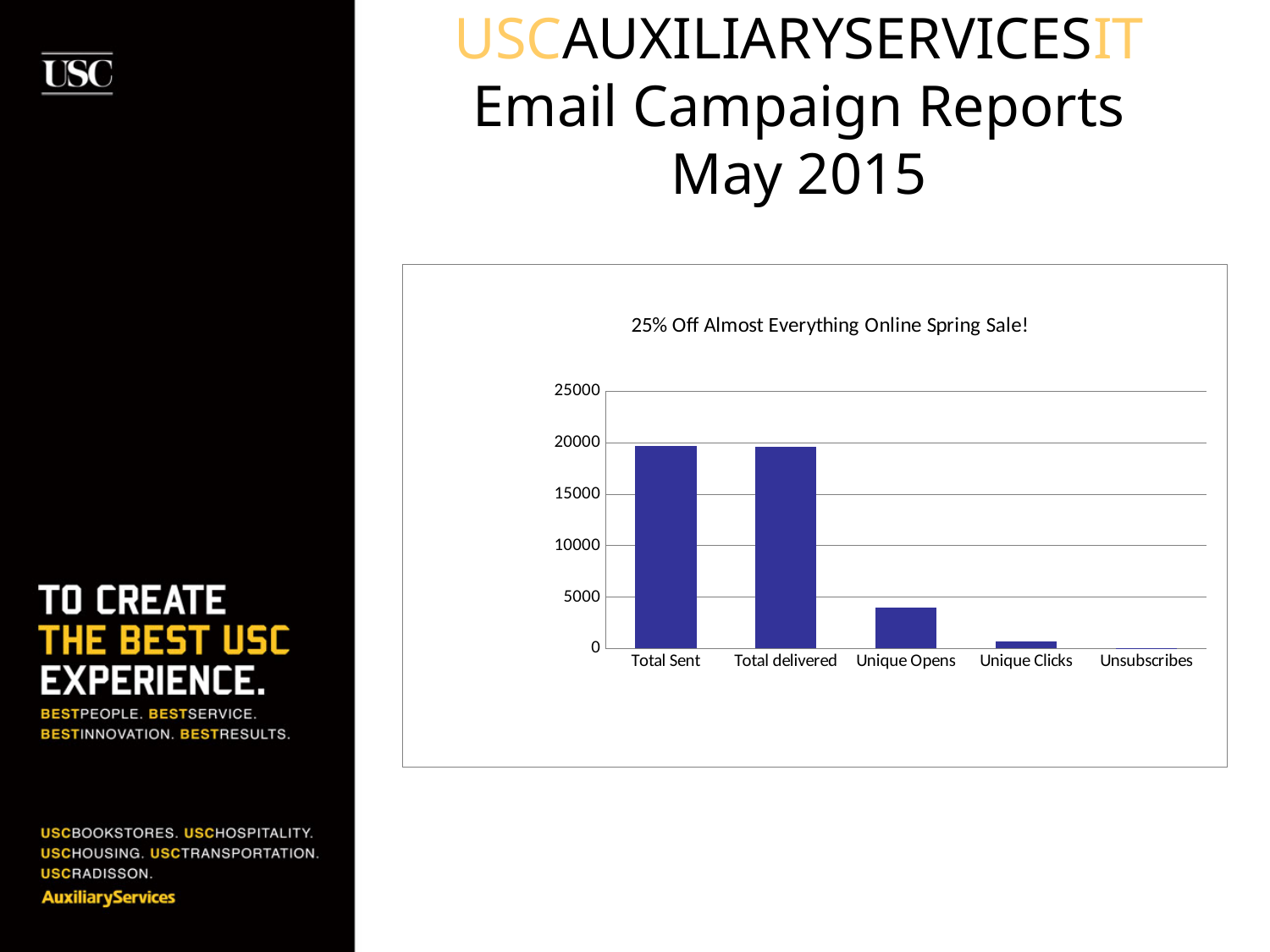
Do the values rise or fall moving from left to right along the x axis? fall Is the value for Total delivered greater or less than 10000? greater Which is larger, the value for Total delivered or the value for Unique Opens? Total delivered What is the highest value shown on the chart's vertical axis? 25000 Which category has the lowest value on the chart? Unsubscribes Is the value for Unique Clicks greater or less than 5000? less Is the value for Total Sent greater or less than 15000? greater What kind of chart is shown on the slide? bar chart What is the title of the chart? 25% Off Almost Everything Online Spring Sale! Which is larger, the value for Unique Clicks or the value for Unsubscribes? Unique Clicks How many categories are plotted on the chart? 5